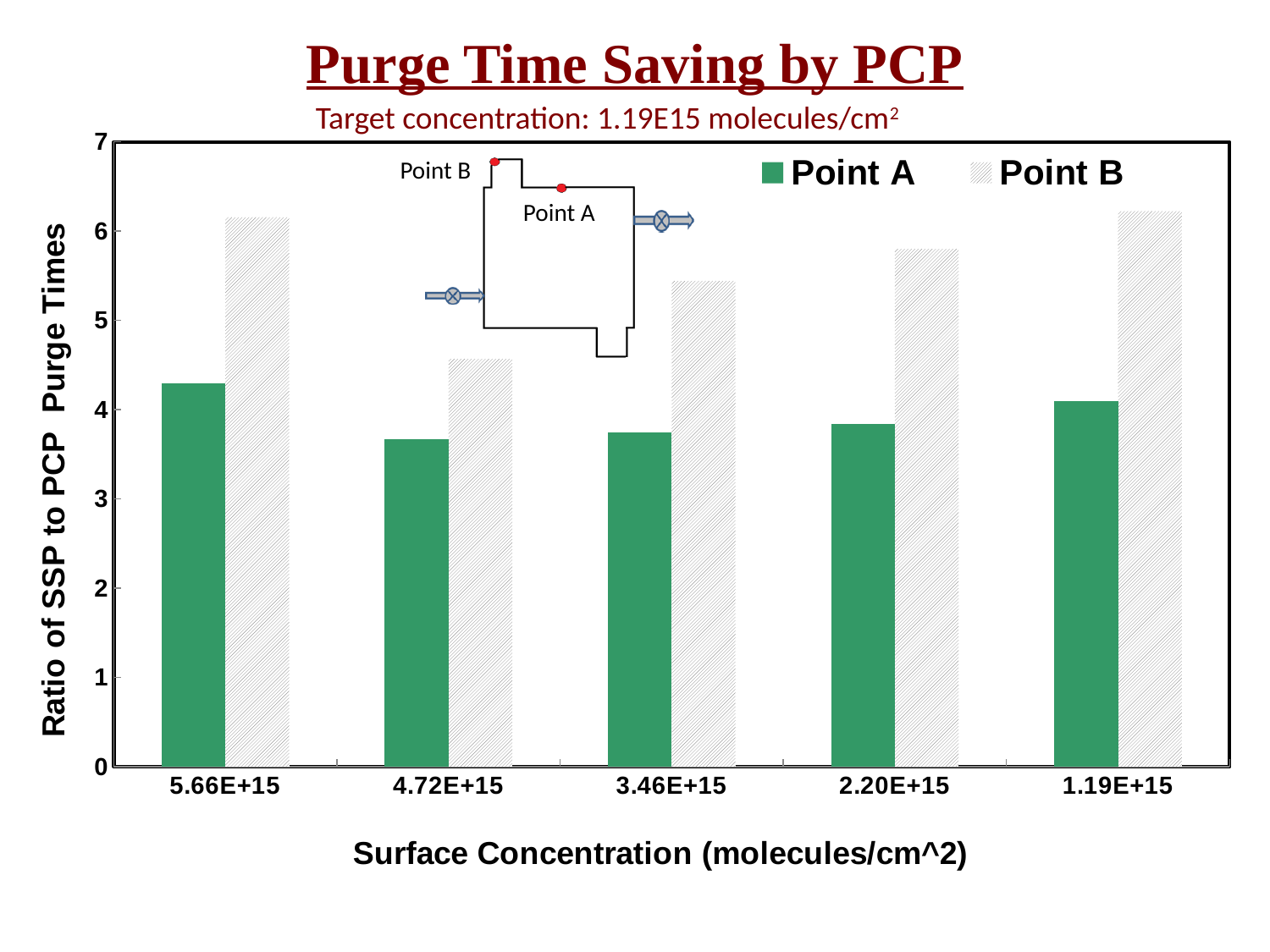
For the Point B series, which surface concentration has the lowest value? 4.72E+15 Is the Point B value at 3.46E+15 greater or less than 5? greater At 2.20E+15, which series has the larger value, Point A or Point B? Point B Is the Point B value at 4.72E+15 greater or less than 5? less Is the Point B value at 5.66E+15 greater or less than 6? greater What is the title of the chart? Purge Time Saving by PCP What is the label of the y axis? Ratio of SSP to PCP Purge Times What kind of chart is shown on the slide? bar chart How many series does the legend list? 2 How many surface concentration categories are shown on the x axis? 5